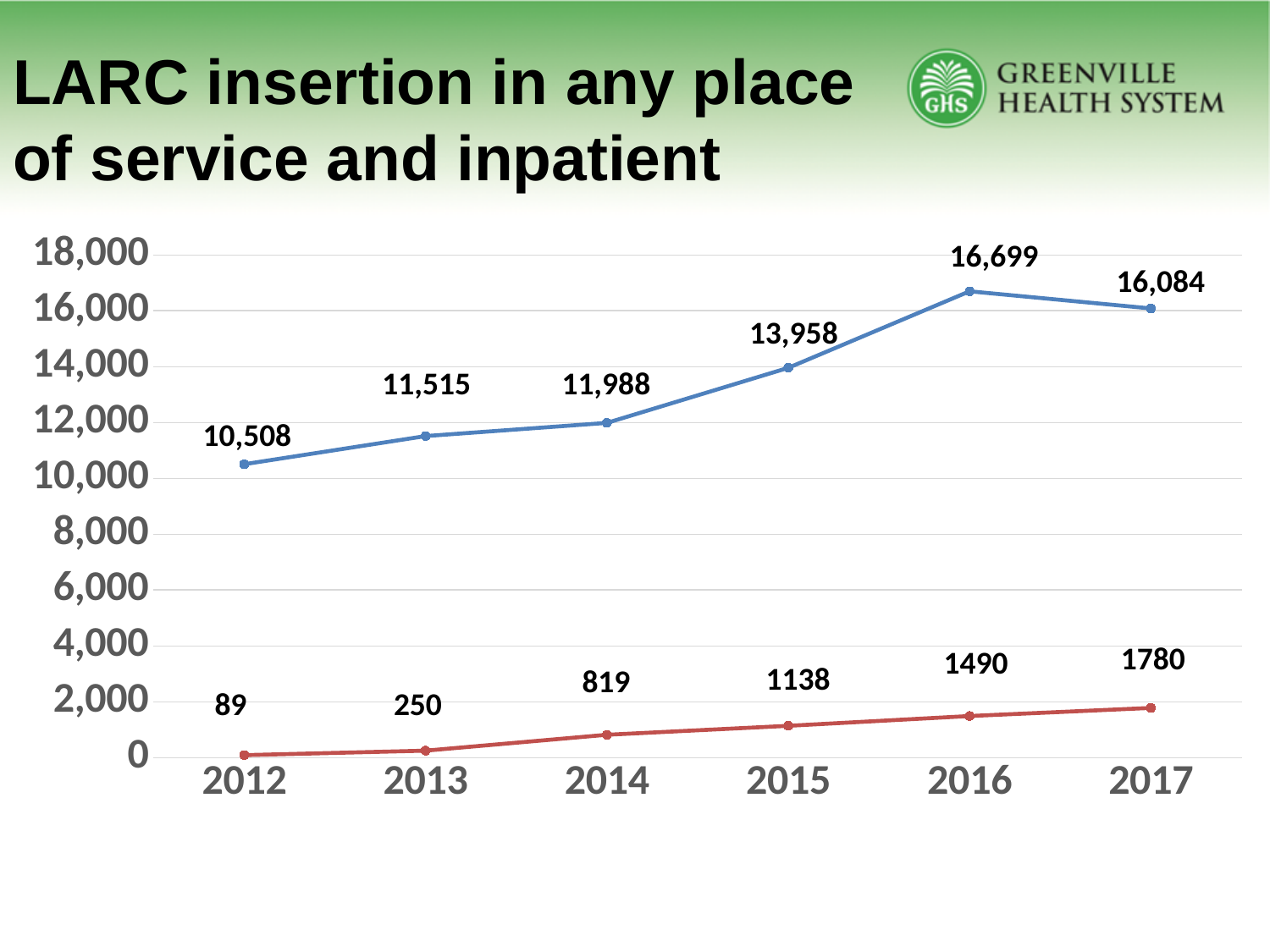
Does the red line rise or fall from 2012 to 2017? rise In which year is the red line at its lowest value? 2012 What is the value of the blue line in 2016? 16,699 In which year does the blue line reach its highest value? 2016 What kind of chart is shown on the slide? line chart What is the difference between the blue line's values in 2016 and 2017? 615 What is the difference between the red line's values in 2017 and 2016? 290 Is the blue line's value in 2015 greater or less than 12,000? greater How many years are shown on the x axis? 6 Which is larger, the blue line's value in 2015 or its value in 2014? 2015 What is the value of the blue line in 2012? 10,508 What is the value of the red line in 2014? 819